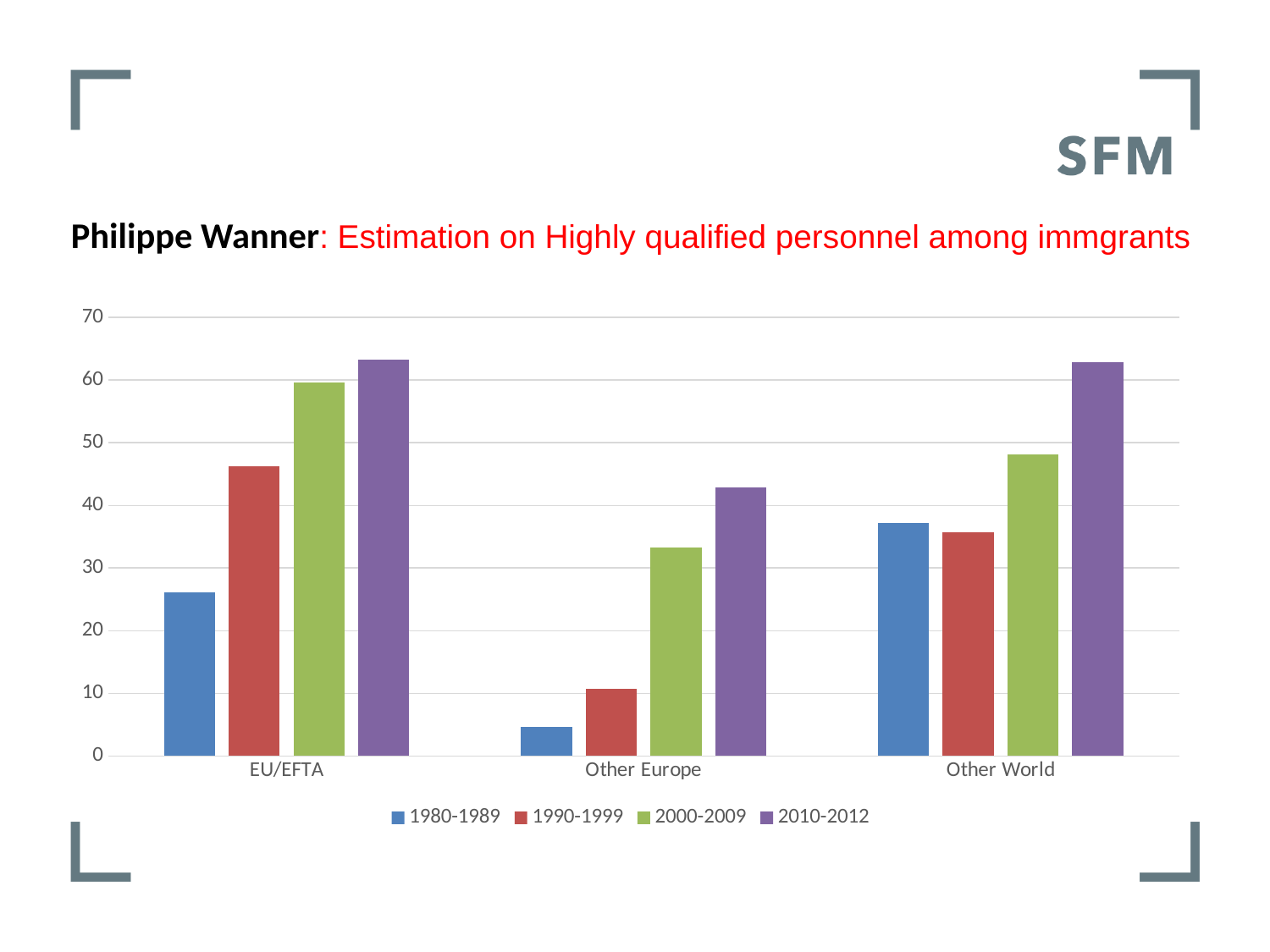
How many series does the legend list? 4 Which colour represents the 2010-2012 series in the legend? purple Do the values for EU/EFTA rise or fall from 1980-1989 to 2010-2012? rise Is the value for 1990-1999 in Other Europe greater or less than 20? less Which is larger: the 2000-2009 value for EU/EFTA or the 2000-2009 value for Other World? EU/EFTA What kind of chart is shown on the slide? bar chart Is the value for 1980-1989 in EU/EFTA greater or less than 30? less Which series has the lowest value for EU/EFTA? 1980-1989 How many categories are shown on the x axis? 3 Which category has the lowest value for 1980-1989? Other Europe Which series has the highest value for Other Europe? 2010-2012 Is the value for 2010-2012 in Other Europe greater or less than 40? greater